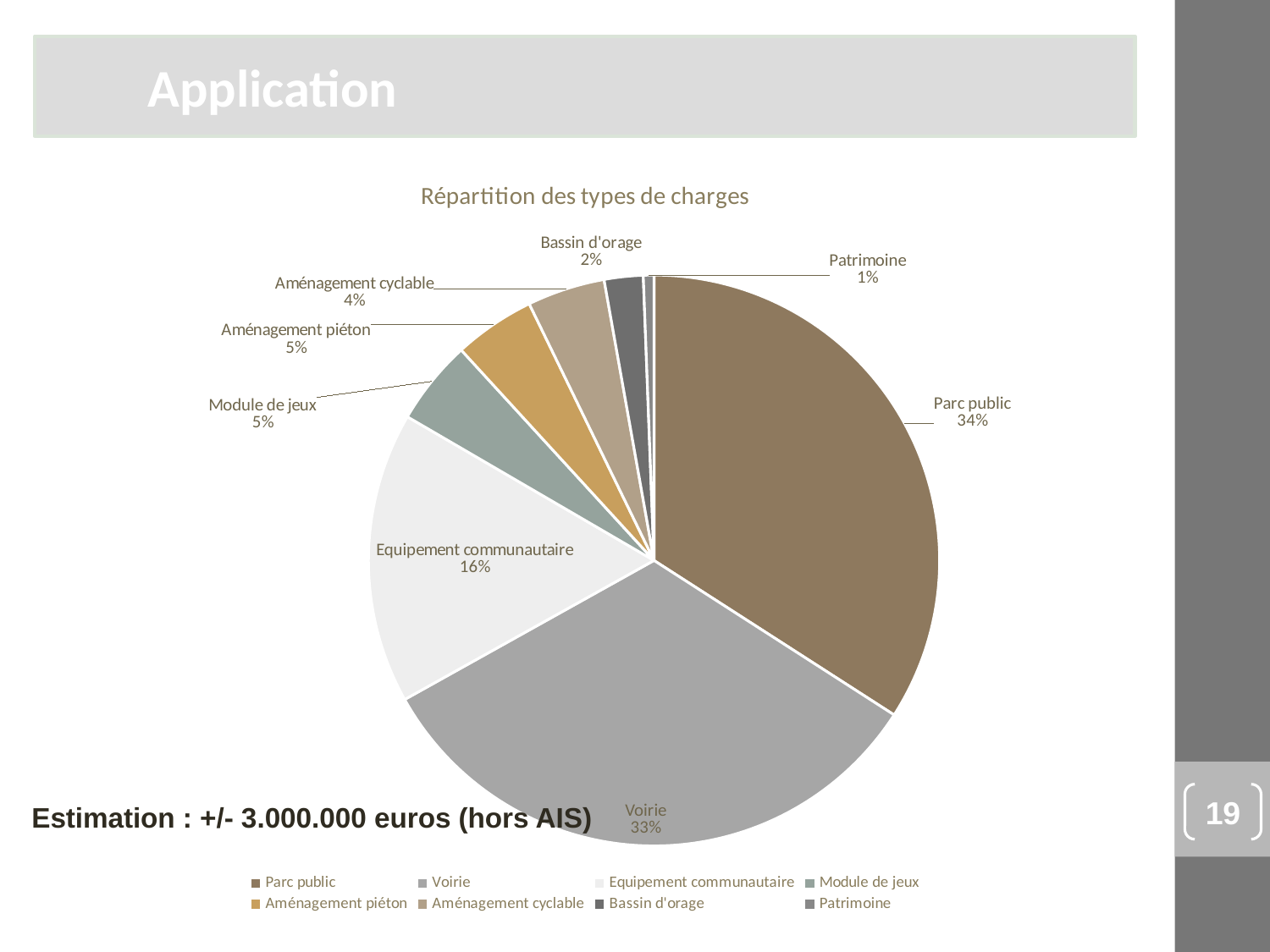
How many slices does the pie chart have? 8 Which category has the smallest share of the pie? Patrimoine What share of the pie does Parc public represent? 34% What is the value shown for Bassin d'orage? 2% Which category has the largest share of the pie? Parc public What type of chart is shown on the slide? pie chart What is the value shown for Aménagement cyclable? 4% What share of the pie does Voirie represent? 33% What is the difference in percentage points between Equipement communautaire and Module de jeux? 11 What is the title of the chart? Répartition des types de charges Which is larger, the share for Aménagement piéton or the share for Bassin d'orage? Aménagement piéton What is the value shown for Equipement communautaire? 16%